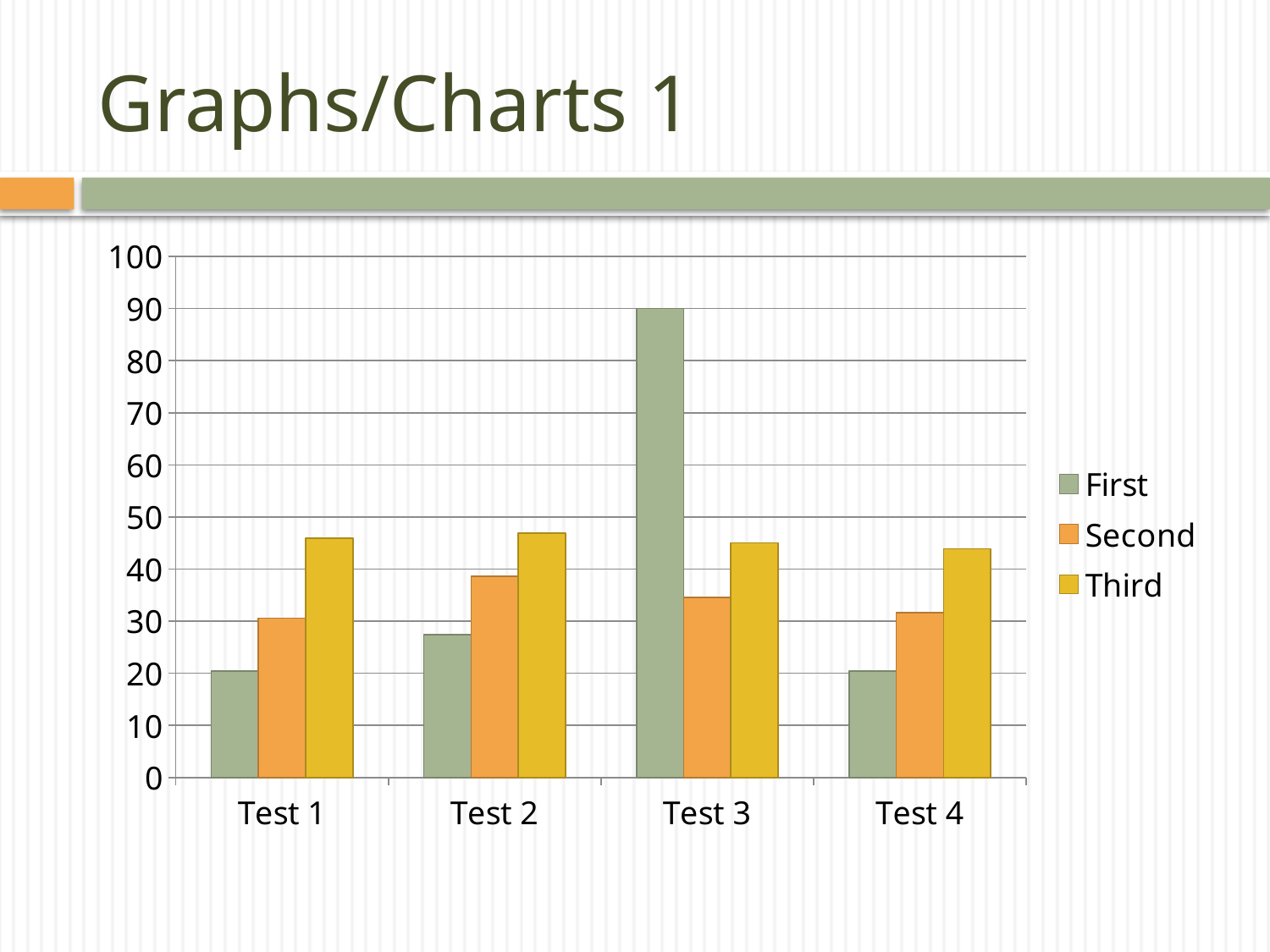
Is the value of the Third series for Test 2 greater or less than 40? greater For which test is the First series highest? Test 3 How many series does the legend list? 3 For Test 3, which is larger: the First series or the Second series? First For Test 1, which is larger: the First series or the Third series? Third Is the value of the First series for Test 3 greater or less than 80? greater How many categories are shown on the x axis? 4 Is the value of the Second series for Test 1 greater or less than 40? less What are the names of the three series in the legend? First, Second, Third What kind of chart is shown on the slide? bar chart What is the value of the First series for Test 3? 90